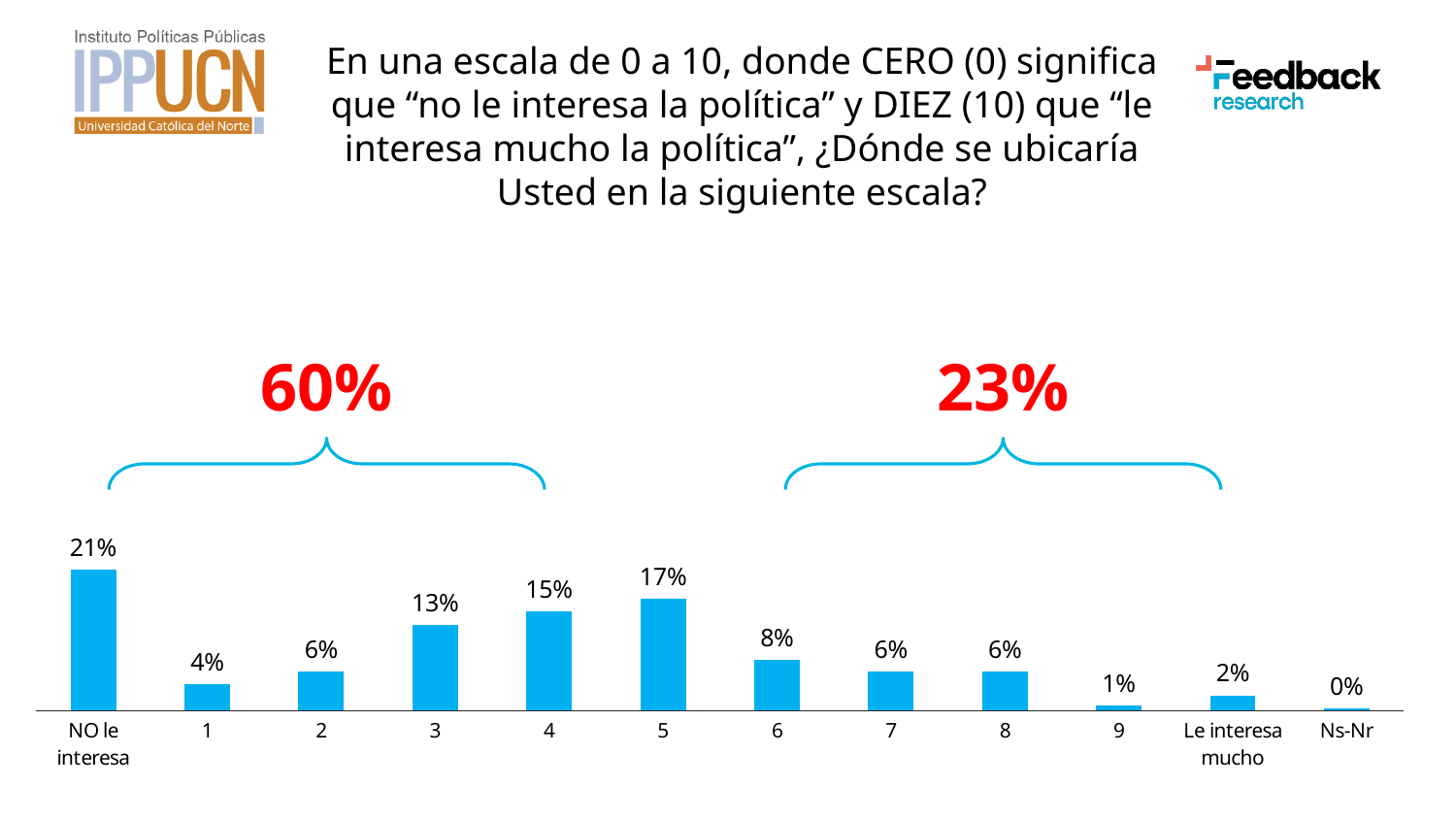
What is the value for the category "NO le interesa"? 21% Which category has the lowest value? Ns-Nr What kind of chart is shown on the slide? bar chart What is the value for the category "Ns-Nr"? 0% Which is larger, the value for category 6 or the value for category 9? category 6 What is the value for category 5? 17% What is the difference between the values for category 4 and category 3? 2% What percentage is shown above the bracket covering the left group of bars (from "NO le interesa" to 4)? 60% What is the value for the category "Le interesa mucho"? 2% How many categories are shown on the x axis? 12 What percentage is shown above the bracket covering the right group of bars (from 6 to "Le interesa mucho")? 23% Which category has the highest value? NO le interesa